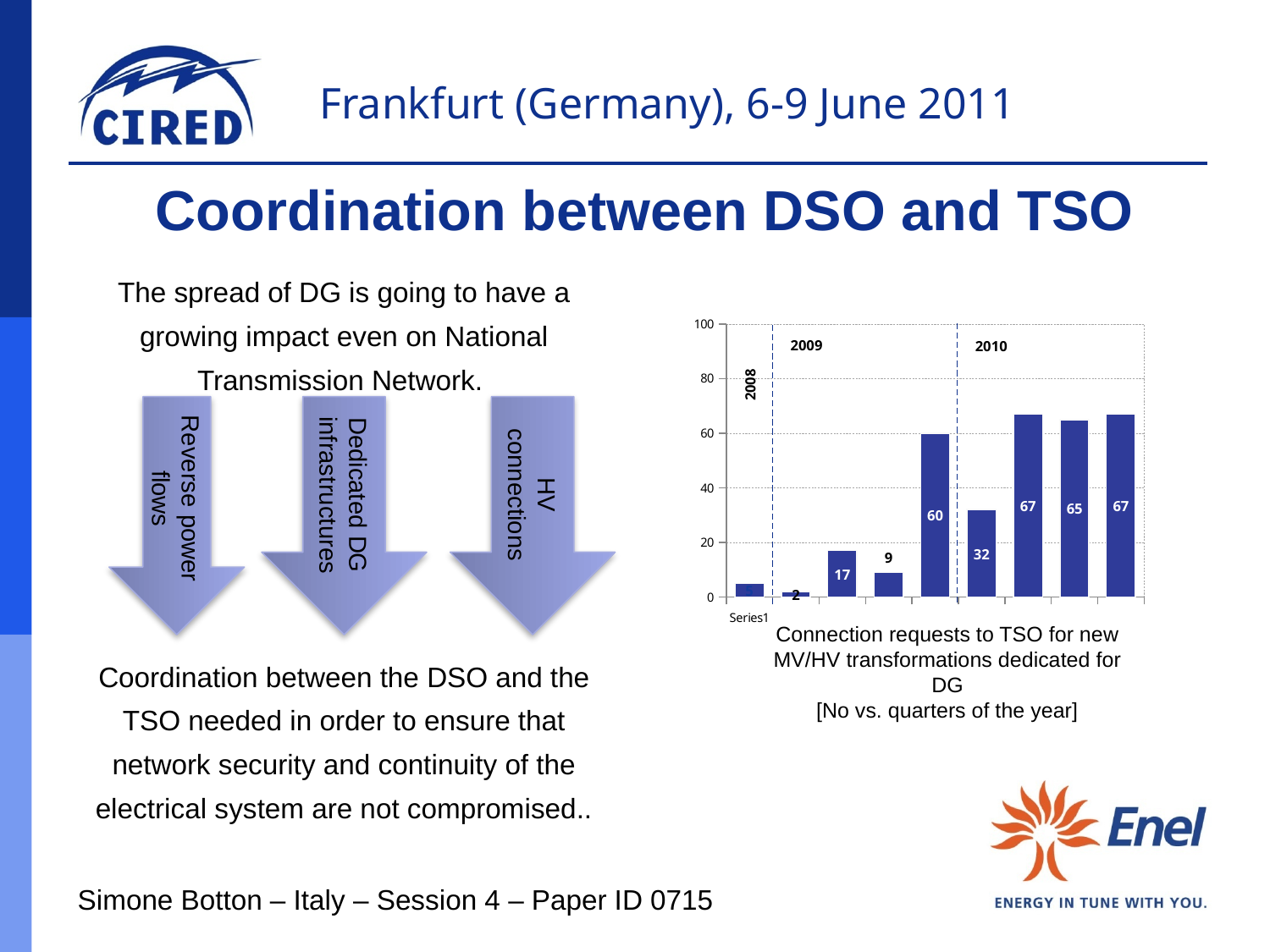
What is the difference between the last bar of 2009 (60) and the first bar of 2010 (32)? 28 What is the value of the last bar in the 2009 section of the chart? 60 Which is larger: the bar labelled 17 or the bar labelled 9? 17 Which years are marked on the chart? 2008, 2009, 2010 What is the value of the second bar in the 2009 section of the chart? 17 What kind of chart is shown on the slide? bar chart What does the caption below the chart say the bars represent? Connection requests to TSO for new MV/HV transformations dedicated for DG What is the value of the first bar in the 2010 section of the chart? 32 What is the value of the tallest bar in the chart? 67 How many bars are plotted in the chart? 9 What is the value of the third bar in the 2010 section of the chart? 65 Is the value of the first bar (2008) greater or less than 20? less